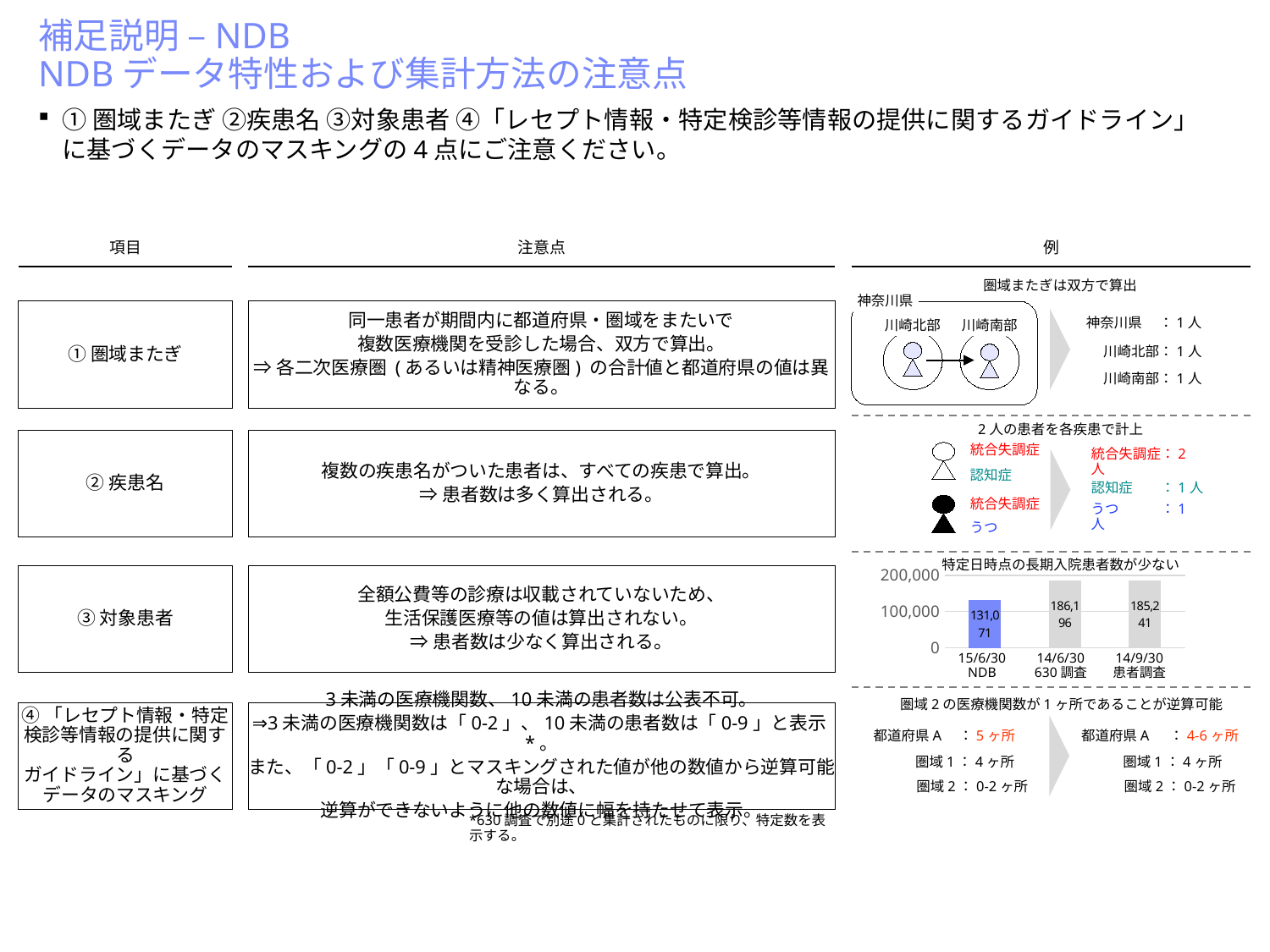
In the bar chart in the ③ 対象患者 example, is the value for 14/6/30 630調査 greater or less than 200,000? less In the bar chart in the ③ 対象患者 example, what is the value for 15/6/30 NDB? 131,071 In the bar chart in the ③ 対象患者 example, what is the difference between the 14/6/30 630調査 value and the 15/6/30 NDB value? 55,125 In the bar chart in the ③ 対象患者 example, what is the value for 14/6/30 630調査? 186,196 In the bar chart in the ③ 対象患者 example, what is the value for 14/9/30 患者調査? 185,241 In the bar chart in the ③ 対象患者 example, which category has the highest value? 14/6/30 630調査 In the bar chart in the ③ 対象患者 example, which category has the lowest value? 15/6/30 NDB In the bar chart in the ③ 対象患者 example, what is the difference between the 14/9/30 患者調査 value and the 15/6/30 NDB value? 54,170 In the bar chart in the ③ 対象患者 example, which is larger: the value for 15/6/30 NDB or the value for 14/9/30 患者調査? 14/9/30 患者調査 How many bars are shown in the bar chart in the ③ 対象患者 example? 3 What kind of chart is shown in the ③ 対象患者 example? bar chart In the bar chart in the ③ 対象患者 example, is the value for 15/6/30 NDB greater or less than 100,000? greater